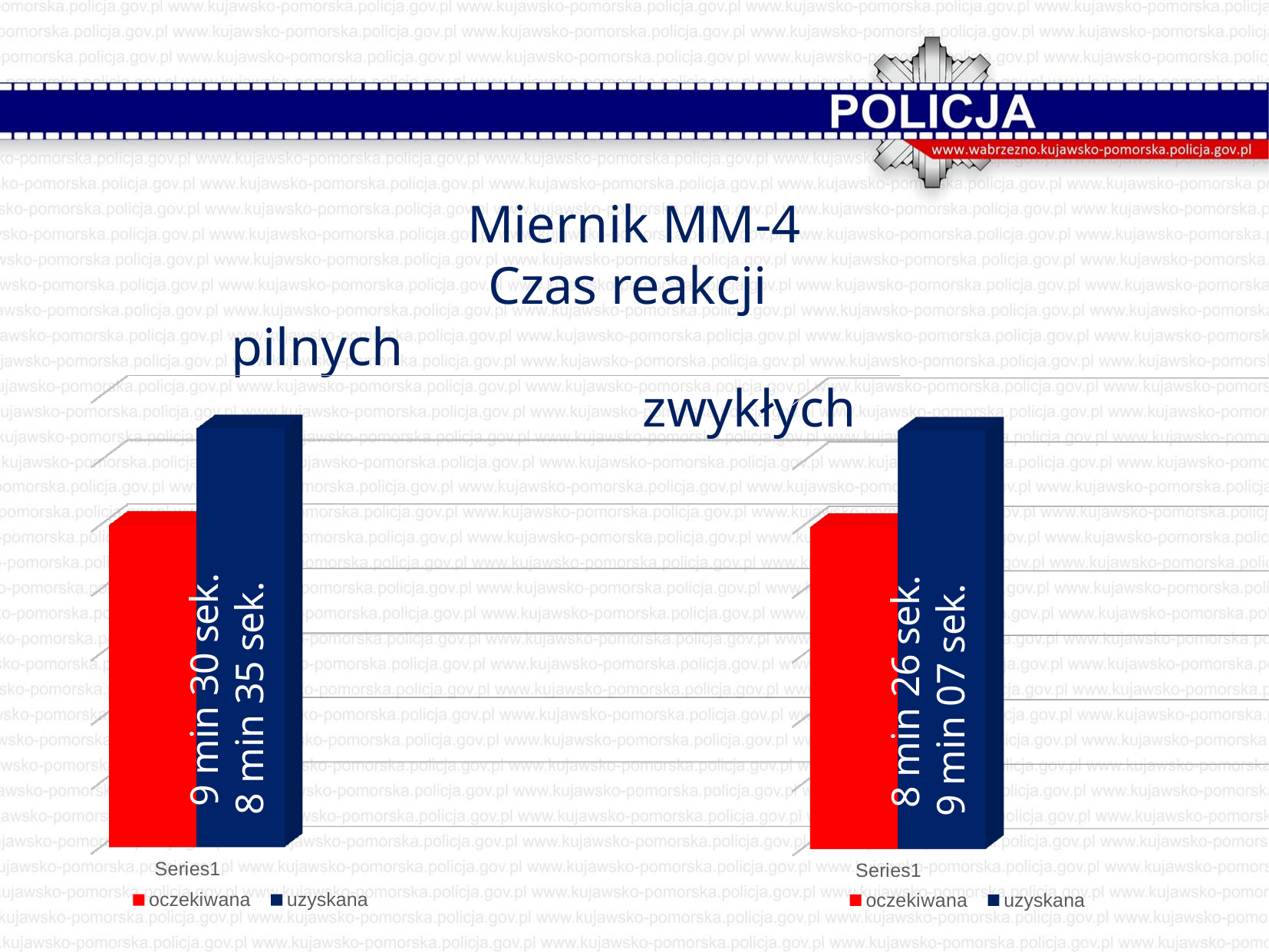
In the 'zwykłych' chart on the right, what is the difference between 'uzyskana' and 'oczekiwana'? 41 sek. In the 'pilnych' chart on the left, what is the value for 'uzyskana'? 8 min 35 sek. How many categories are shown on the x axis of the 'pilnych' chart on the left? 1 In the 'zwykłych' chart on the right, which is larger, 'oczekiwana' or 'uzyskana'? uzyskana Which colour represents 'oczekiwana' in the 'zwykłych' chart on the right? red In the 'zwykłych' chart on the right, what is the value for 'oczekiwana'? 8 min 26 sek. What are the legend entries of the 'pilnych' chart on the left? oczekiwana, uzyskana How many series does the legend of the 'zwykłych' chart on the right list? 2 What kind of chart is the 'pilnych' chart on the left? bar chart In the 'pilnych' chart on the left, what is the difference between 'oczekiwana' and 'uzyskana'? 55 sek. In the 'pilnych' chart on the left, what is the value for 'oczekiwana'? 9 min 30 sek. In the 'zwykłych' chart on the right, what is the value for 'uzyskana'? 9 min 07 sek.